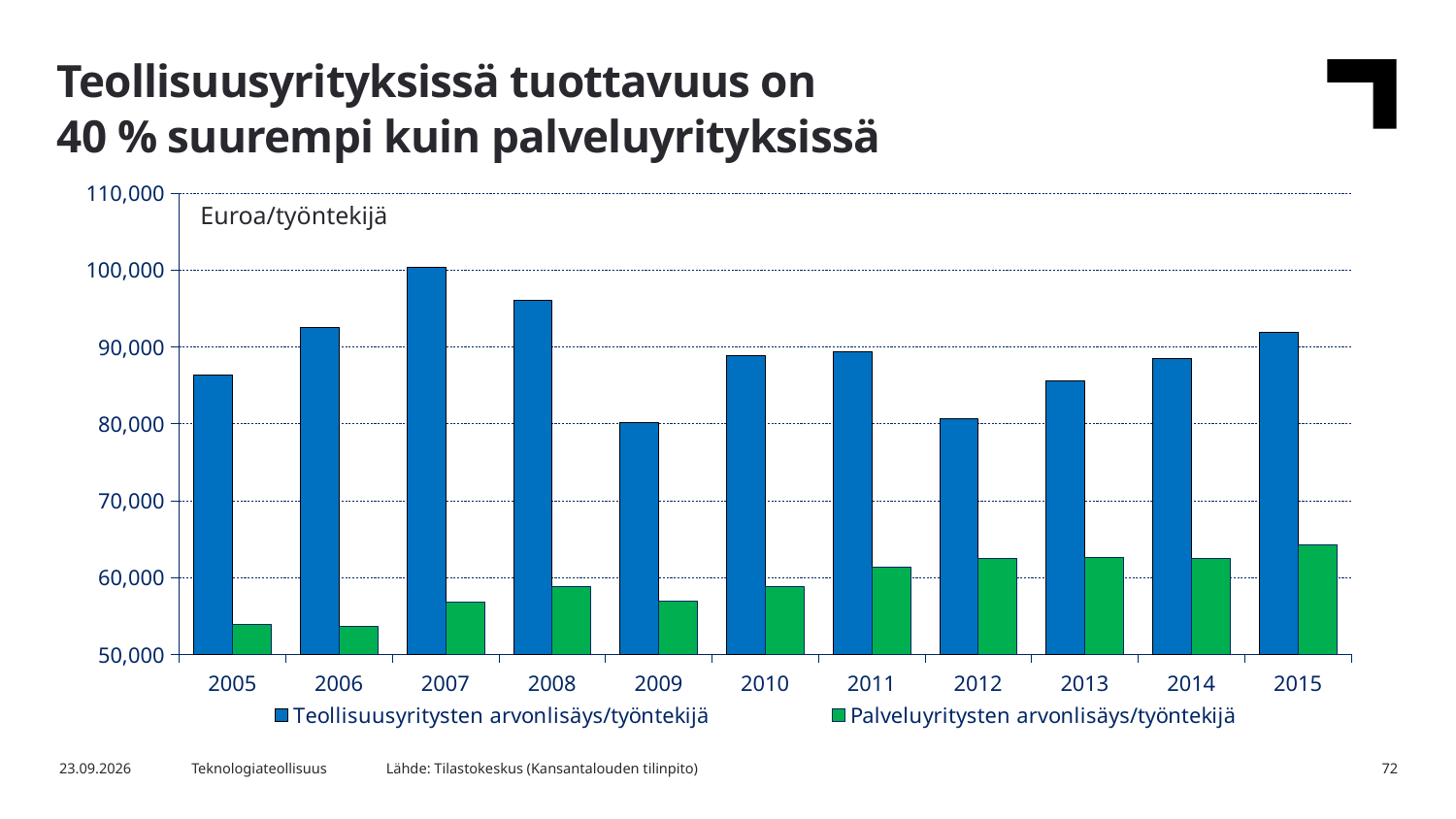
How many series does the legend list? 2 In which year is the value for Teollisuusyritysten arvonlisäys/työntekijä highest? 2007 Does the value for Palveluyritysten arvonlisäys/työntekijä generally rise or fall from 2005 to 2015? Rise Is the value for Palveluyritysten arvonlisäys/työntekijä in 2005 greater or less than 60,000? less What kind of chart is shown on the slide? Bar chart Is the value for Teollisuusyritysten arvonlisäys/työntekijä in 2008 greater or less than 90,000? greater What unit label is shown inside the chart area? Euroa/työntekijä Is the value for Palveluyritysten arvonlisäys/työntekijä in 2015 greater or less than 60,000? greater How many years are shown on the x axis? 11 In which year is the value for Palveluyritysten arvonlisäys/työntekijä highest? 2015 Which is larger: Teollisuusyritysten arvonlisäys/työntekijä in 2008 or in 2015? 2008